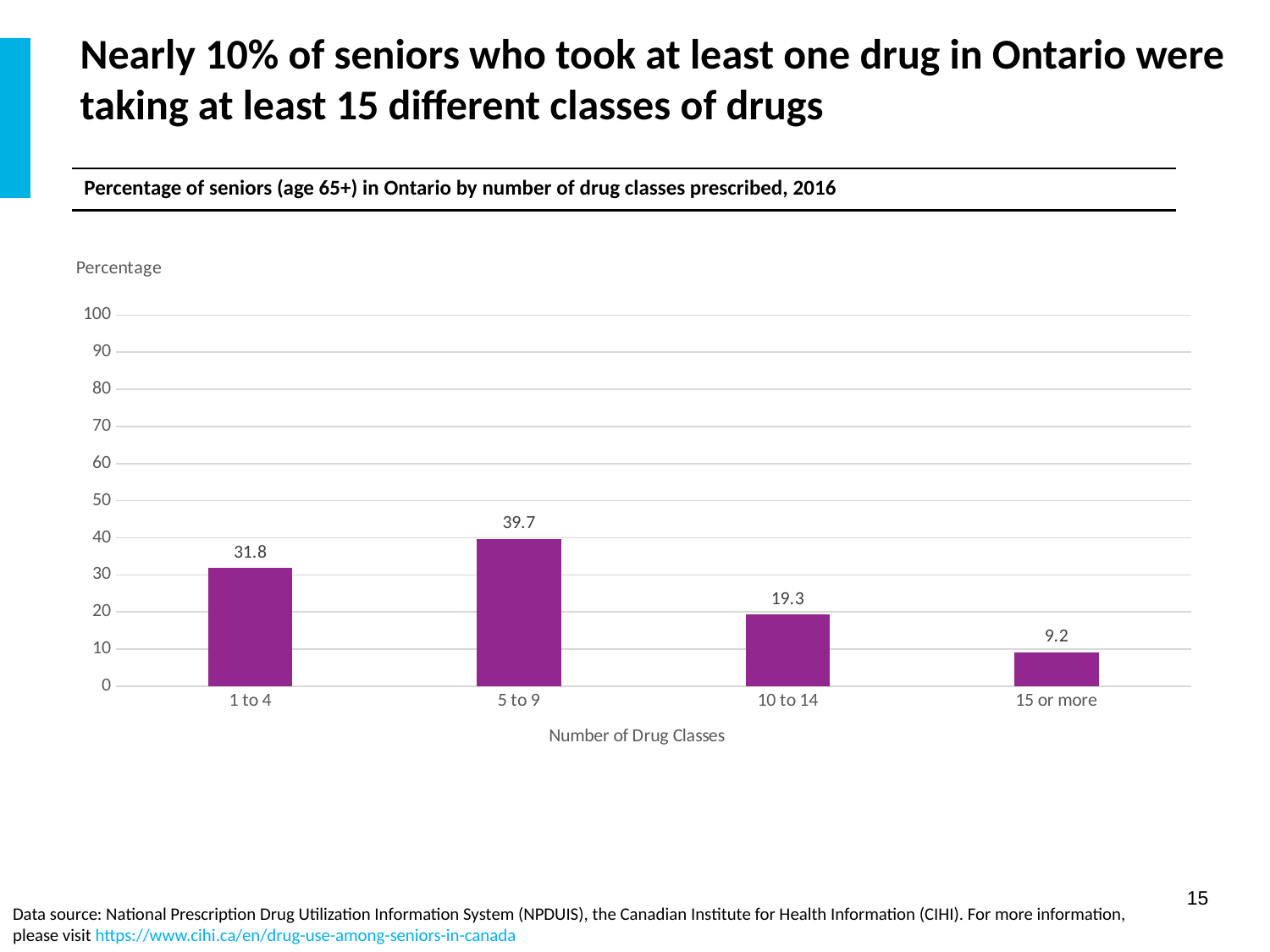
What is the percentage of seniors prescribed 10 to 14 drug classes? 19.3 Which category has a larger percentage, 1 to 4 or 10 to 14? 1 to 4 What is the difference in percentage between the 10 to 14 and 15 or more categories? 10.1 Which number of drug classes category has the lowest percentage? 15 or more What is the label of the x axis of the chart? Number of Drug Classes What is the difference in percentage between the 5 to 9 and 1 to 4 categories? 7.9 What is the percentage of seniors prescribed 5 to 9 drug classes? 39.7 What is the percentage of seniors prescribed 1 to 4 drug classes? 31.8 How many number-of-drug-classes categories are shown on the chart? 4 Which number of drug classes category has the highest percentage? 5 to 9 What is the percentage of seniors prescribed 15 or more drug classes? 9.2 What type of chart is shown on the slide? Bar chart